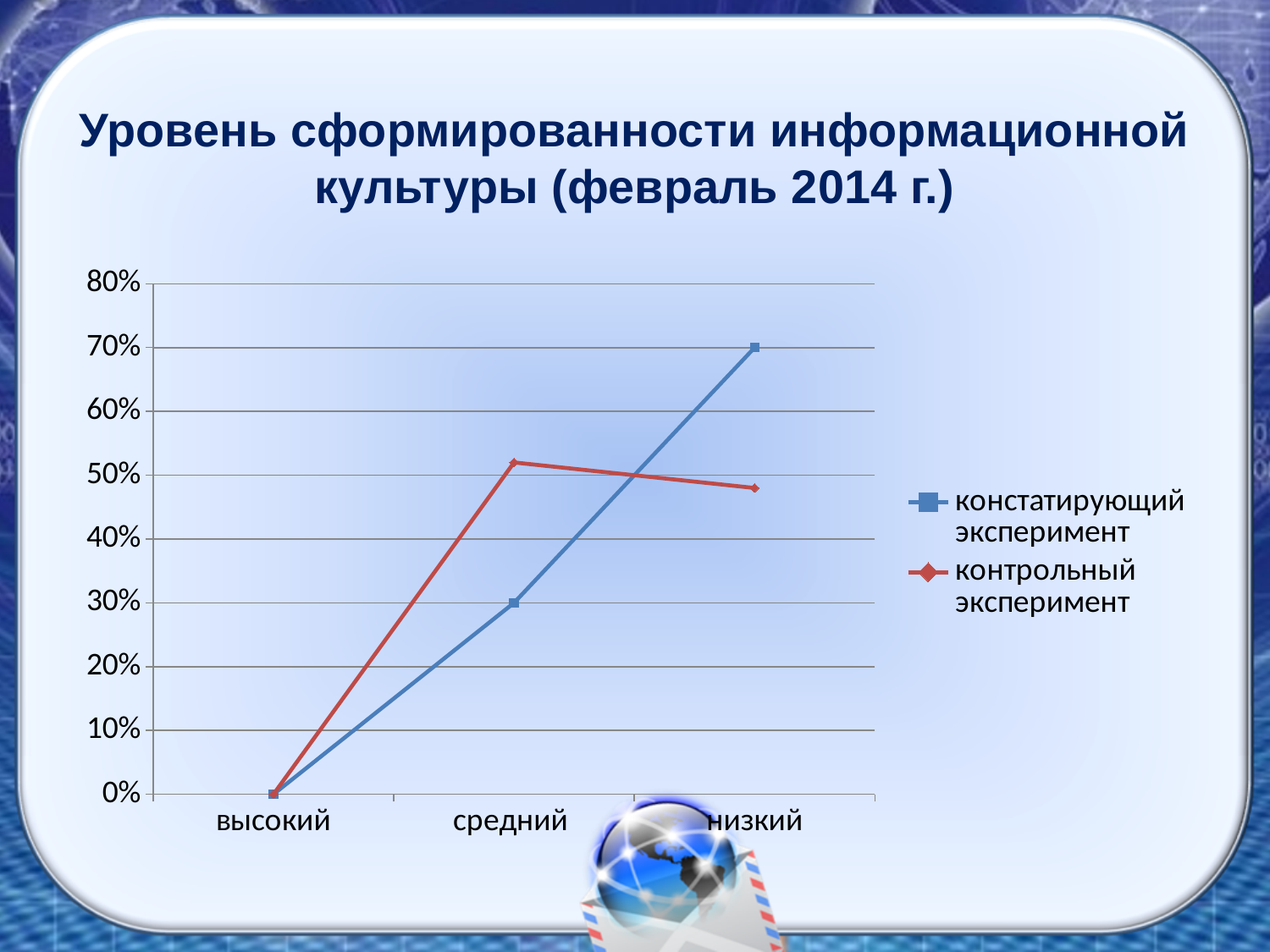
What kind of chart is shown on the slide? line chart Which category has the highest value in the 'констатирующий эксперимент' series? низкий What is the value for 'высокий' in the 'контрольный эксперимент' series? 0% For 'низкий', which series has the larger value: 'констатирующий эксперимент' or 'контрольный эксперимент'? констатирующий эксперимент How many categories are shown on the x axis? 3 How many series does the legend list? 2 What is the value for 'низкий' in the 'констатирующий эксперимент' series? 70% What is the difference between the 'низкий' and 'средний' values in the 'констатирующий эксперимент' series? 40% Which category has the highest value in the 'контрольный эксперимент' series? средний Is the value for 'низкий' in the 'контрольный эксперимент' series greater or less than 50%? less What is the value for 'средний' in the 'констатирующий эксперимент' series? 30% Is the value for 'средний' in the 'контрольный эксперимент' series greater or less than 50%? greater